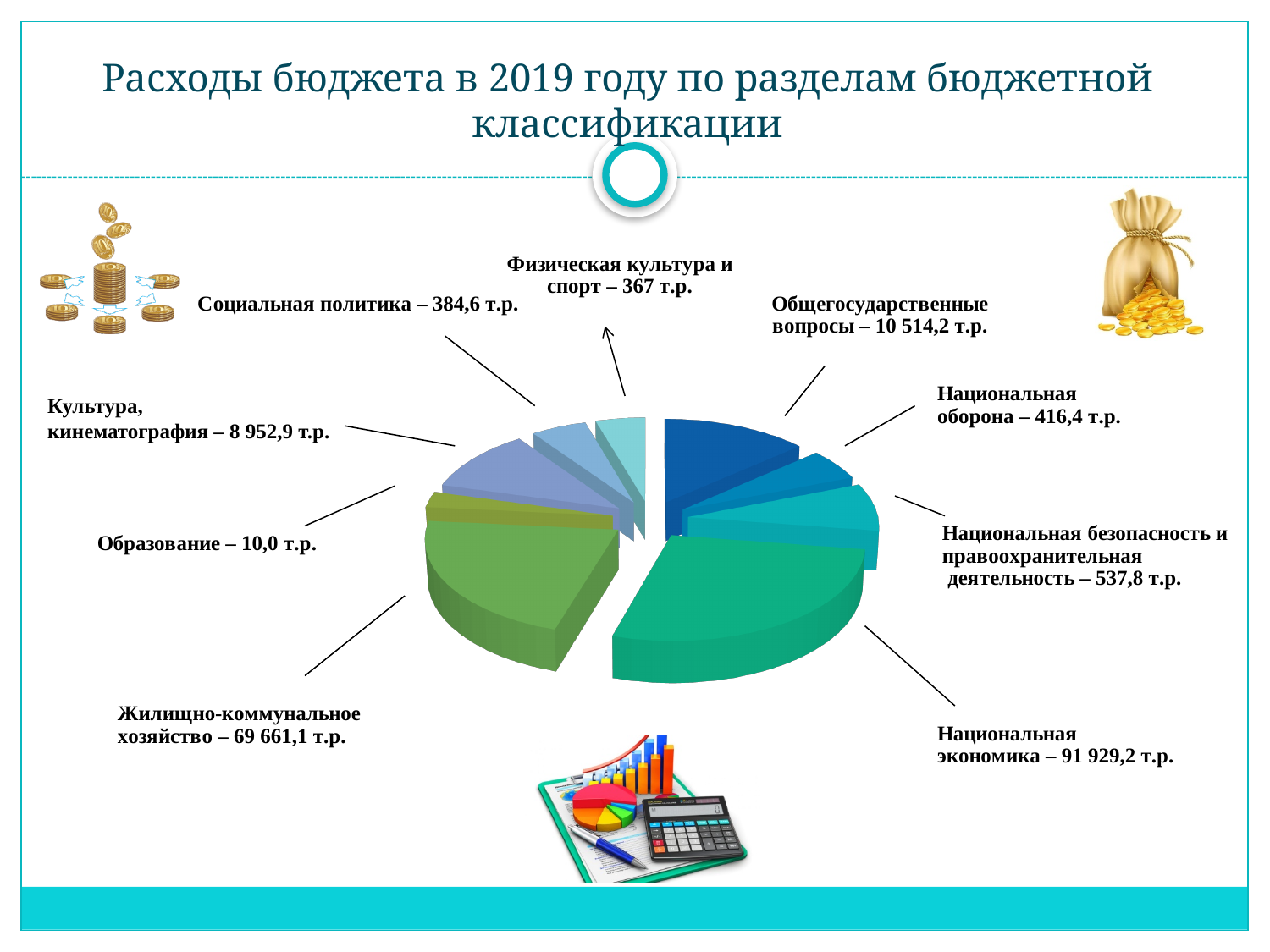
What is the difference between Национальная экономика and Жилищно-коммунальное хозяйство? 22 268,1 т.р. What is the difference between Национальная безопасность и правоохранительная деятельность and Национальная оборона? 121,4 т.р. What is the value for Физическая культура и спорт? 367 т.р. What is the value for Национальная экономика? 91 929,2 т.р. What is the value for Жилищно-коммунальное хозяйство? 69 661,1 т.р. What is the value for Общегосударственные вопросы? 10 514,2 т.р. What kind of chart is shown on the slide? Pie chart What is the title of the slide containing the chart? Расходы бюджета в 2019 году по разделам бюджетной классификации Which budget section has the smallest value? Образование Which is larger: Общегосударственные вопросы or Культура, кинематография? Общегосударственные вопросы How many budget sections (slices) are labelled on the pie chart? 9 Which budget section has the largest value? Национальная экономика